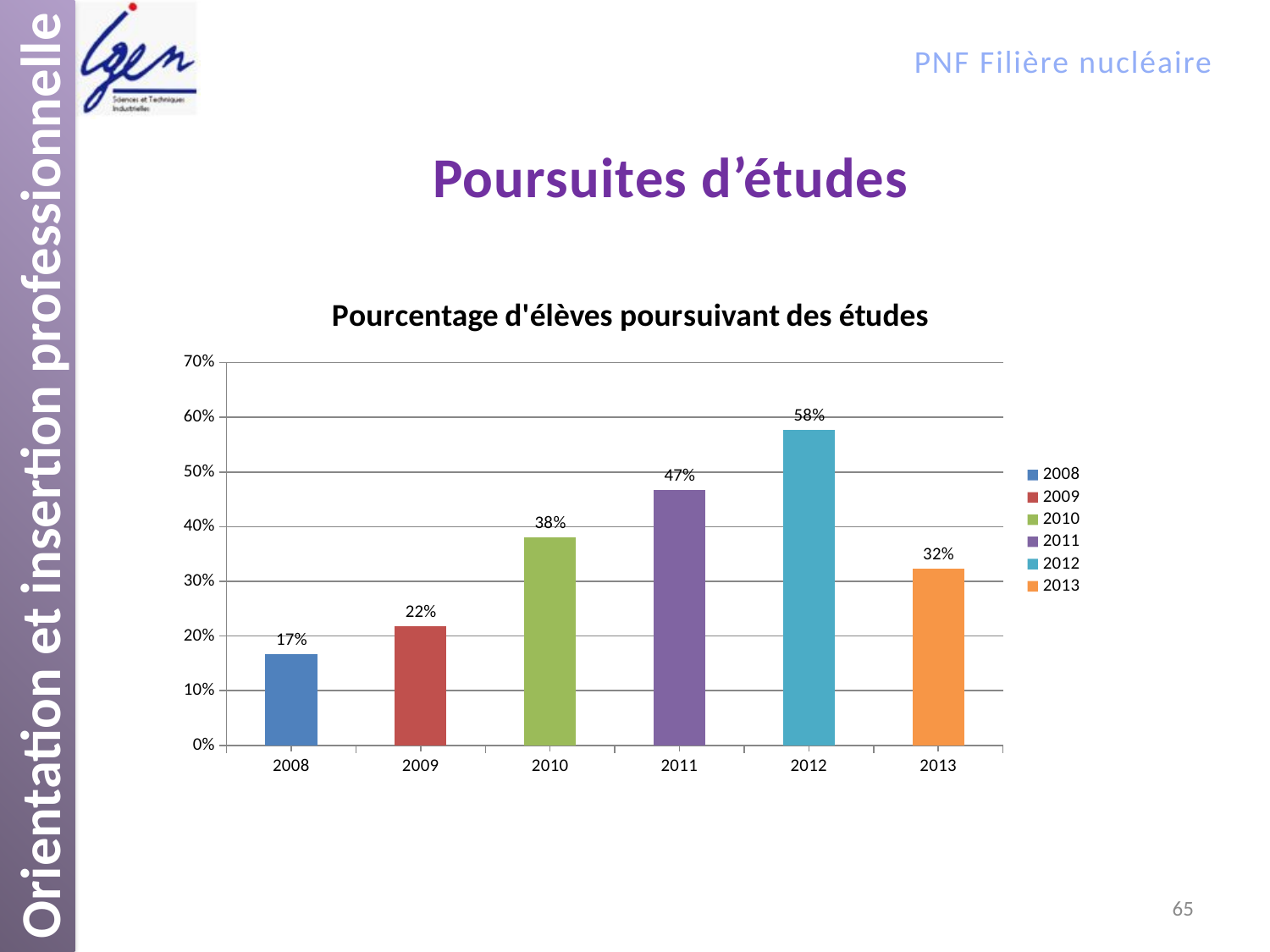
What is the value for 2010? 38% What is the value for 2013? 32% What kind of chart is shown on the slide? bar chart Which is larger, the value for 2009 or the value for 2013? 2013 What is the difference between the values for 2011 and 2010? 9% What is the difference between the values for 2012 and 2008? 41% Is the value for 2011 greater or less than 40%? greater Which year has the highest percentage of students continuing their studies? 2012 What is the title of the chart? Pourcentage d'élèves poursuivant des études Which year has the lowest percentage of students continuing their studies? 2008 How many entries does the legend list? 6 How many years are shown on the x axis? 6